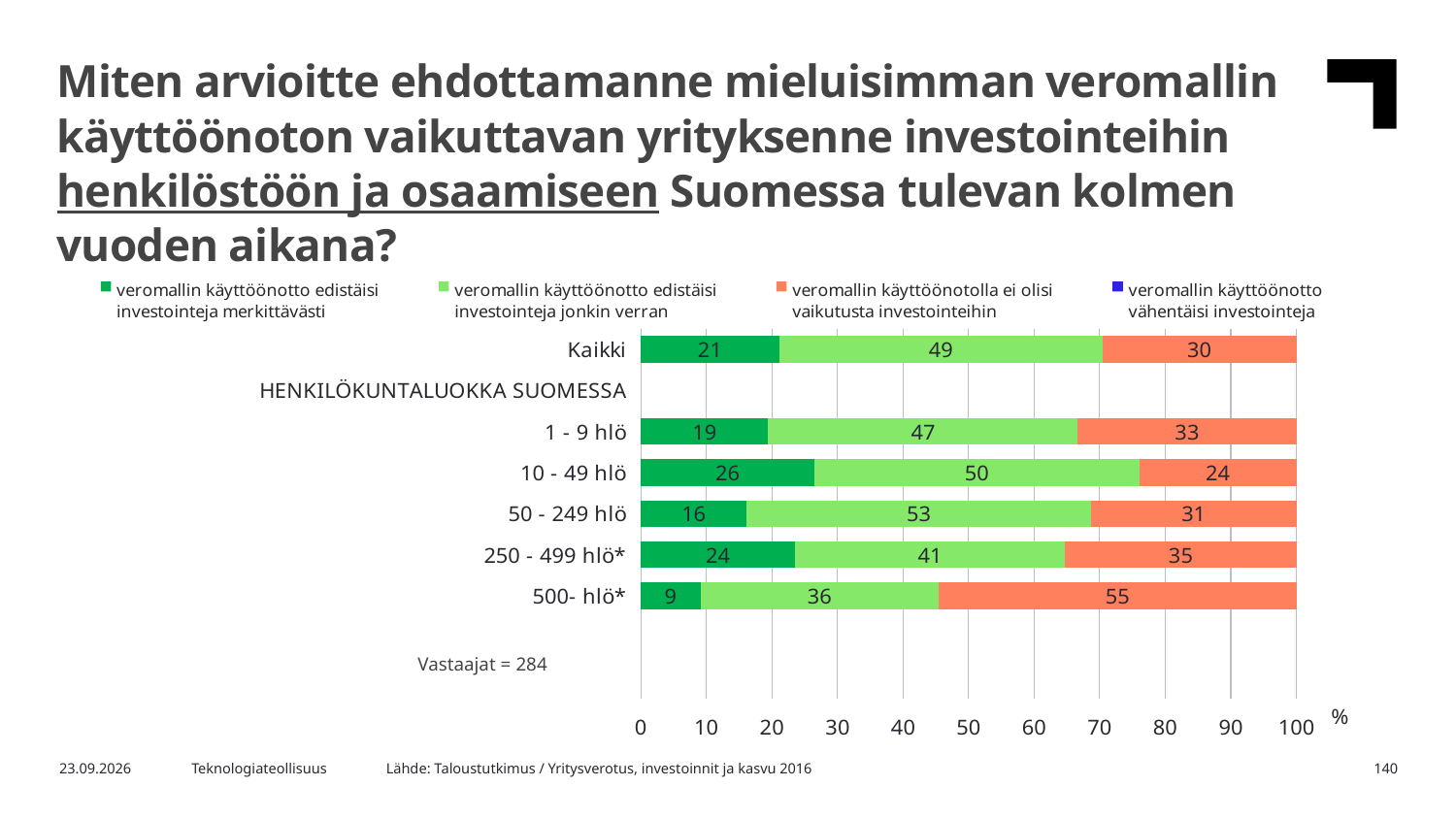
What is the value for 'veromallin käyttöönotto edistäisi investointeja jonkin verran' in the 50 - 249 hlö bar? 53 How many size-class categories (excluding Kaikki) are plotted in the chart? 5 What is the difference between the 'veromallin käyttöönotolla ei olisi vaikutusta investointeihin' values for 500- hlö* and 10 - 49 hlö? 31 How many series does the legend list? 4 What is the value for 'veromallin käyttöönotto edistäisi investointeja merkittävästi' in the Kaikki bar? 21 What is the value for 'veromallin käyttöönotolla ei olisi vaikutusta investointeihin' in the 500- hlö* bar? 55 What kind of chart is shown on the slide? stacked bar chart Which category has the lowest value for 'veromallin käyttöönotto edistäisi investointeja jonkin verran'? 500- hlö* Which category has the highest value for 'veromallin käyttöönotto edistäisi investointeja merkittävästi'? 10 - 49 hlö What is the number of respondents (Vastaajat) shown on the slide? 284 What is the total of the three printed segments in the 1 - 9 hlö bar? 99 Which is larger: the 'veromallin käyttöönotto edistäisi investointeja merkittävästi' value for 250 - 499 hlö* or for 50 - 249 hlö? 250 - 499 hlö*